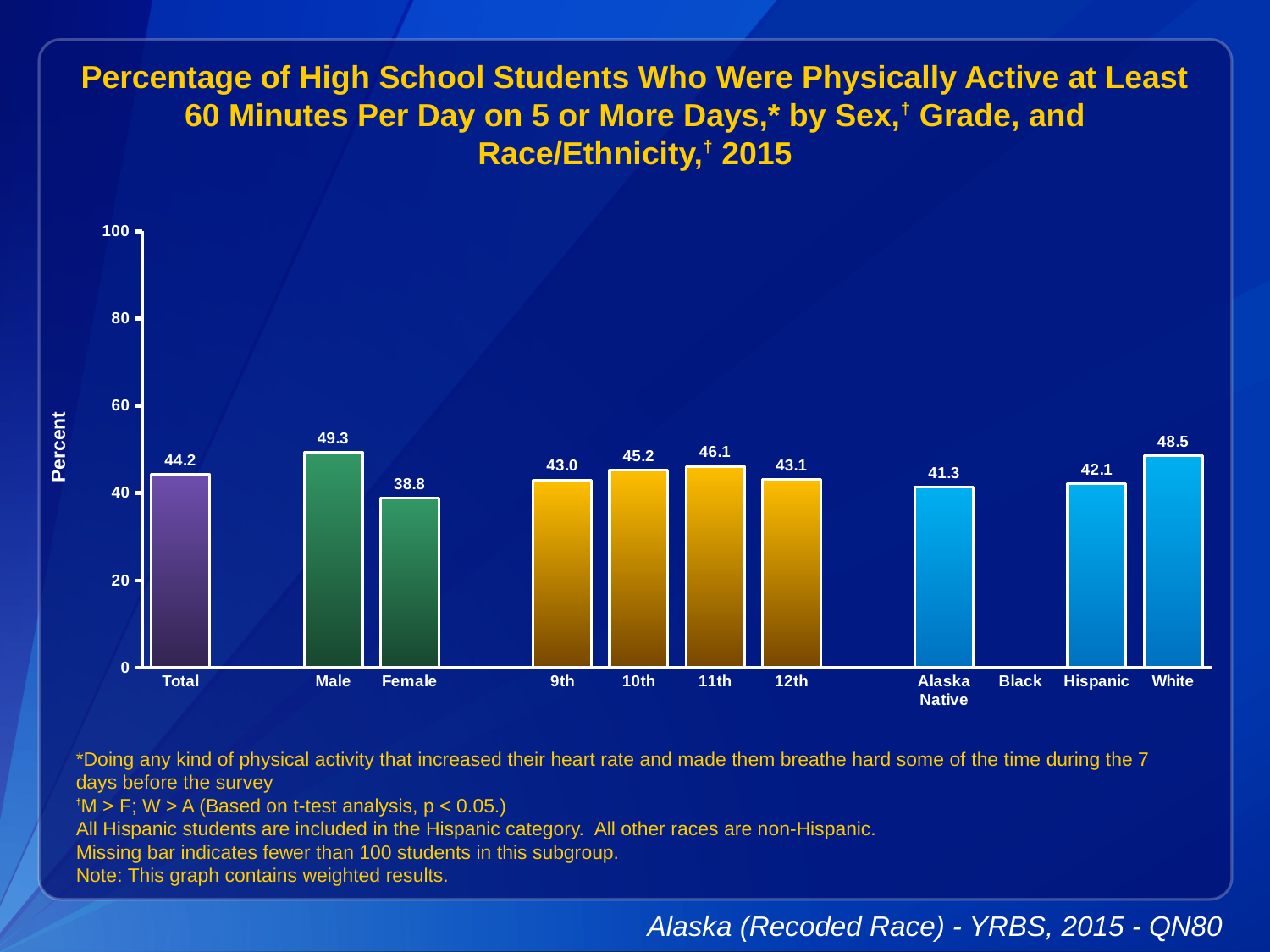
Which category has the lowest value? Female How many bars are plotted on the chart? 10 Is the value for Total greater or less than 40? greater What is the value for Male? 49.3 Which category has the highest value? Male What kind of chart is shown? bar chart What is the value for 11th grade? 46.1 Which category label has no bar plotted? Black What is the value for Female? 38.8 What is the difference between the Male and Female values? 10.5 What is the value for Alaska Native? 41.3 Which is larger, the value for White or the value for Hispanic? White